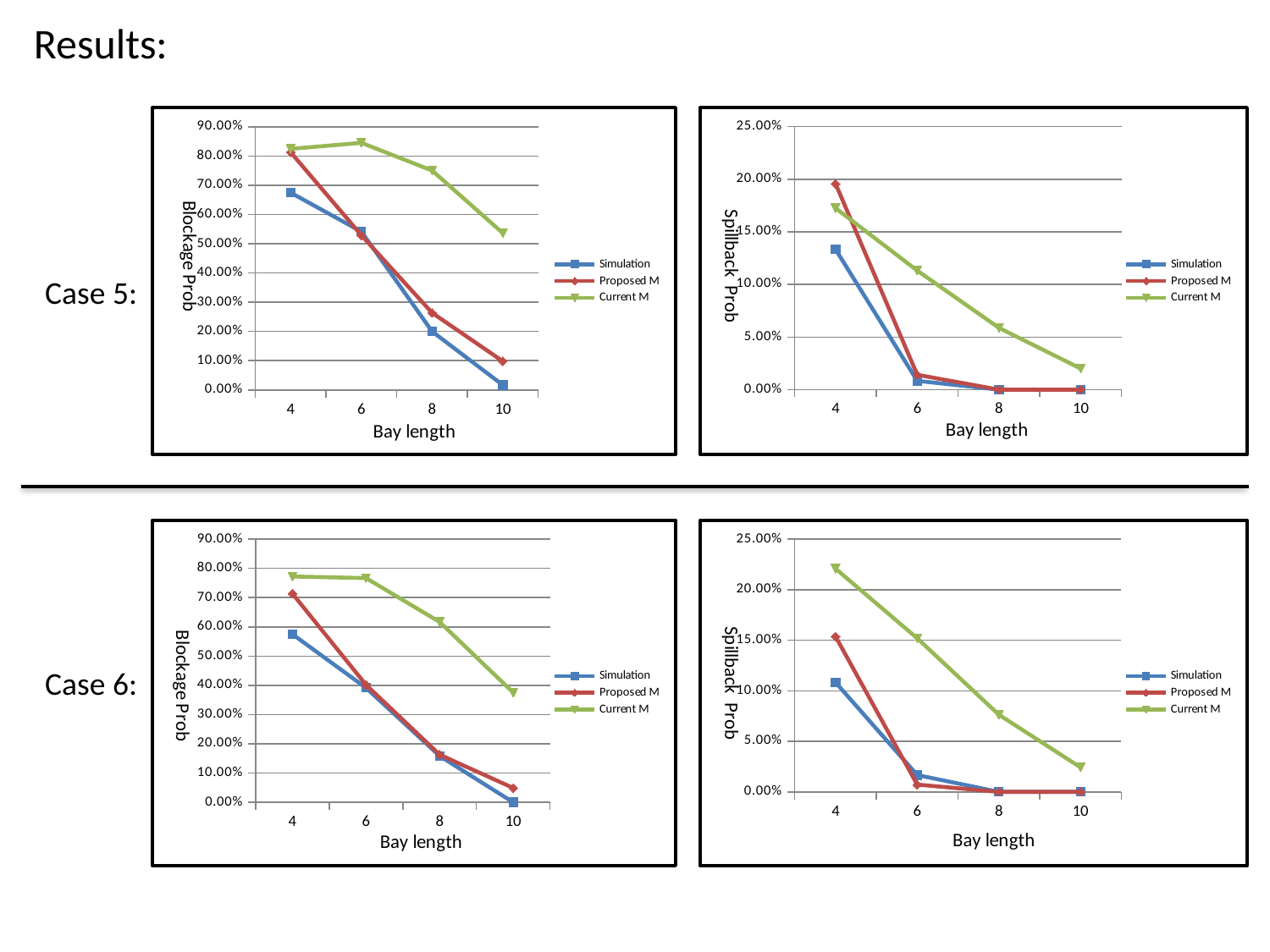
In the Case 5 Blockage Prob chart (top left), does the Simulation series rise or fall as bay length increases? fall How many bay length values are plotted on the x axis of the Case 5 Blockage Prob chart (top left)? 4 In the Case 5 Blockage Prob chart (top left), which series has the highest value at bay length 10? Current M What kind of chart is the Case 5 Blockage Prob chart (top left)? line chart In the Case 6 Spillback Prob chart (bottom right), which series has the lowest value at bay length 4? Simulation In the Case 6 Spillback Prob chart (bottom right), is the Current M value at bay length 4 greater or less than 20.00%? greater How many series does the legend of the Case 6 Spillback Prob chart (bottom right) list? 3 In the Case 5 Spillback Prob chart (top right), is the Proposed M value at bay length 4 greater or less than 15.00%? greater In the Case 6 Blockage Prob chart (bottom left), which is larger at bay length 4: Current M or Simulation? Current M In the Case 5 Blockage Prob chart (top left), is the Current M value at bay length 10 greater or less than 60.00%? less What is the x-axis label of the Case 5 Spillback Prob chart (top right)? Bay length